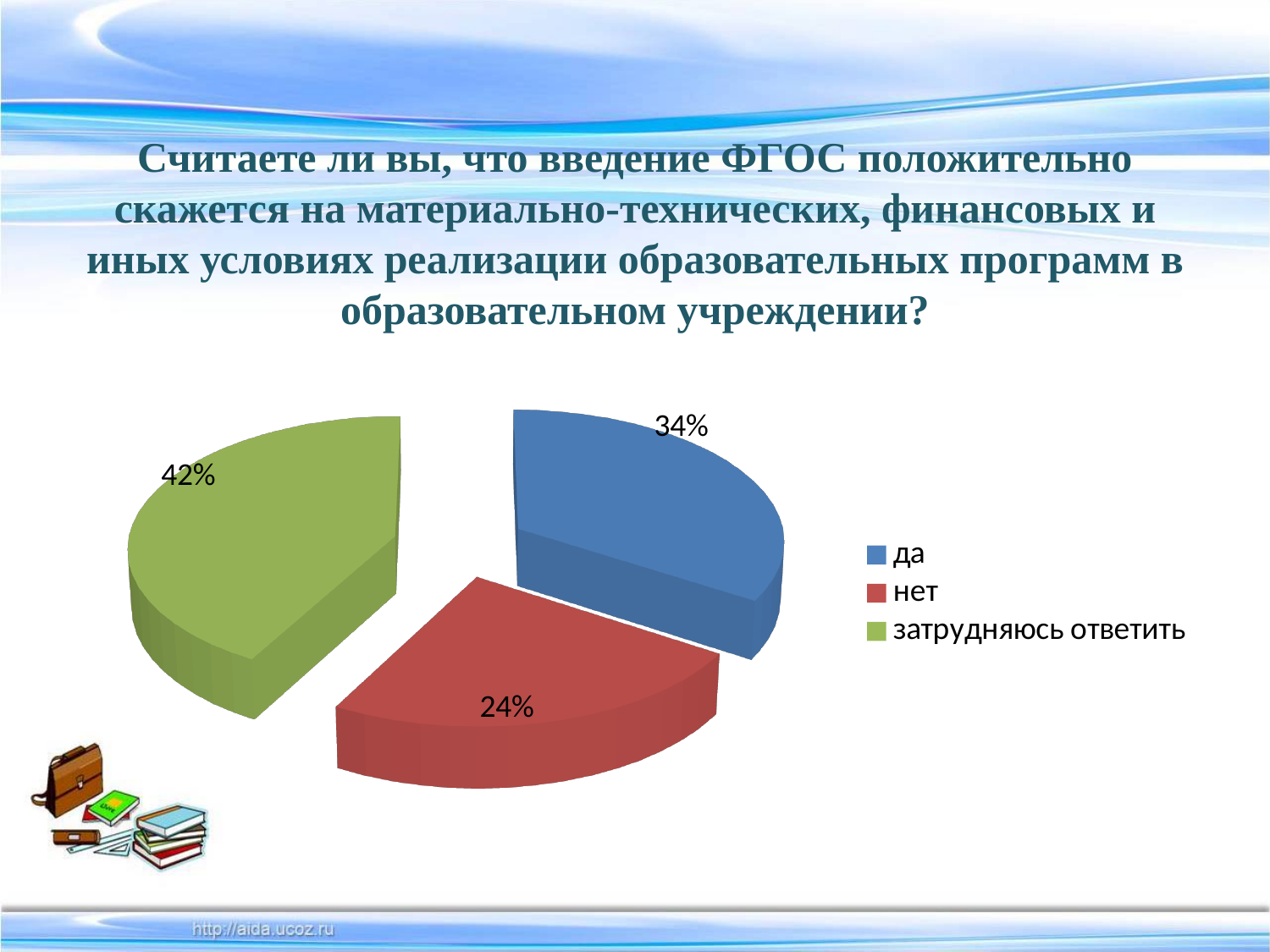
What is the difference in percentage points between "да" and "нет"? 10 How many entries does the legend list? 3 What is the difference in percentage points between "затрудняюсь ответить" and "да"? 8 What percentage of respondents answered "да"? 34% Which is larger, the share for "да" or the share for "нет"? да What percentage of respondents answered "затрудняюсь ответить"? 42% How many slices does the pie chart have? 3 Which response has the largest share of the pie? затрудняюсь ответить What kind of chart is shown on the slide? pie chart What colour is the slice for "нет"? red Which response has the smallest share of the pie? нет What percentage of respondents answered "нет"? 24%